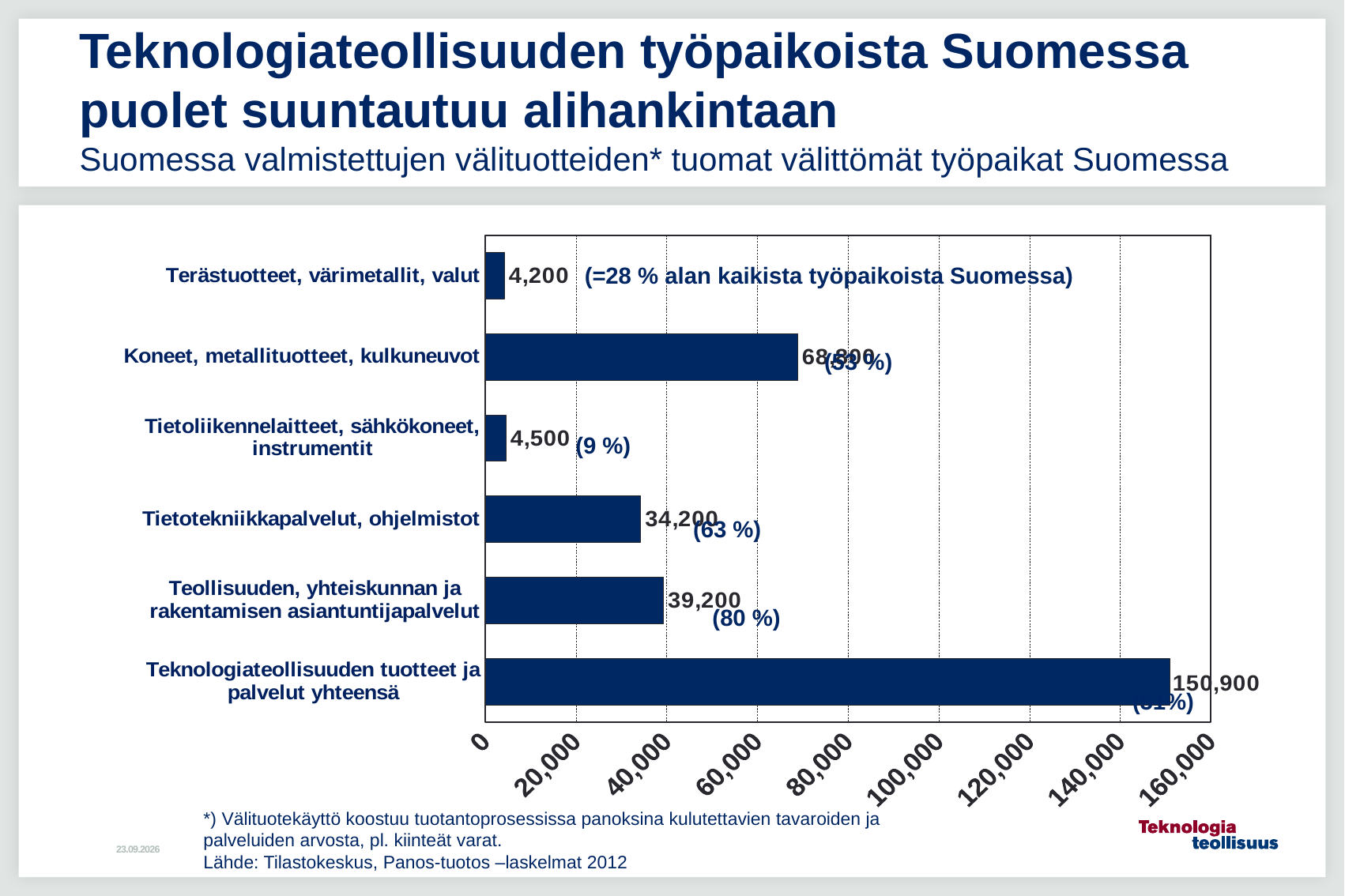
Which category has the lowest value? Terästuotteet, värimetallit, valut What kind of chart is shown on the slide? bar chart What is the value for Teollisuuden, yhteiskunnan ja rakentamisen asiantuntijapalvelut? 39,200 What percentage share is shown next to the bar for Teollisuuden, yhteiskunnan ja rakentamisen asiantuntijapalvelut? 80 % What is the value for Terästuotteet, värimetallit, valut? 4,200 What is the difference between the values for Teollisuuden, yhteiskunnan ja rakentamisen asiantuntijapalvelut and Tietotekniikkapalvelut, ohjelmistot? 5,000 How many categories are plotted in the chart? 6 Which category has the highest value? Teknologiateollisuuden tuotteet ja palvelut yhteensä Is the value for Koneet, metallituotteet, kulkuneuvot greater or less than 60,000? greater What is the value for Tietotekniikkapalvelut, ohjelmistot? 34,200 What is the value for Tietoliikennelaitteet, sähkökoneet, instrumentit? 4,500 What is the value for Teknologiateollisuuden tuotteet ja palvelut yhteensä? 150,900